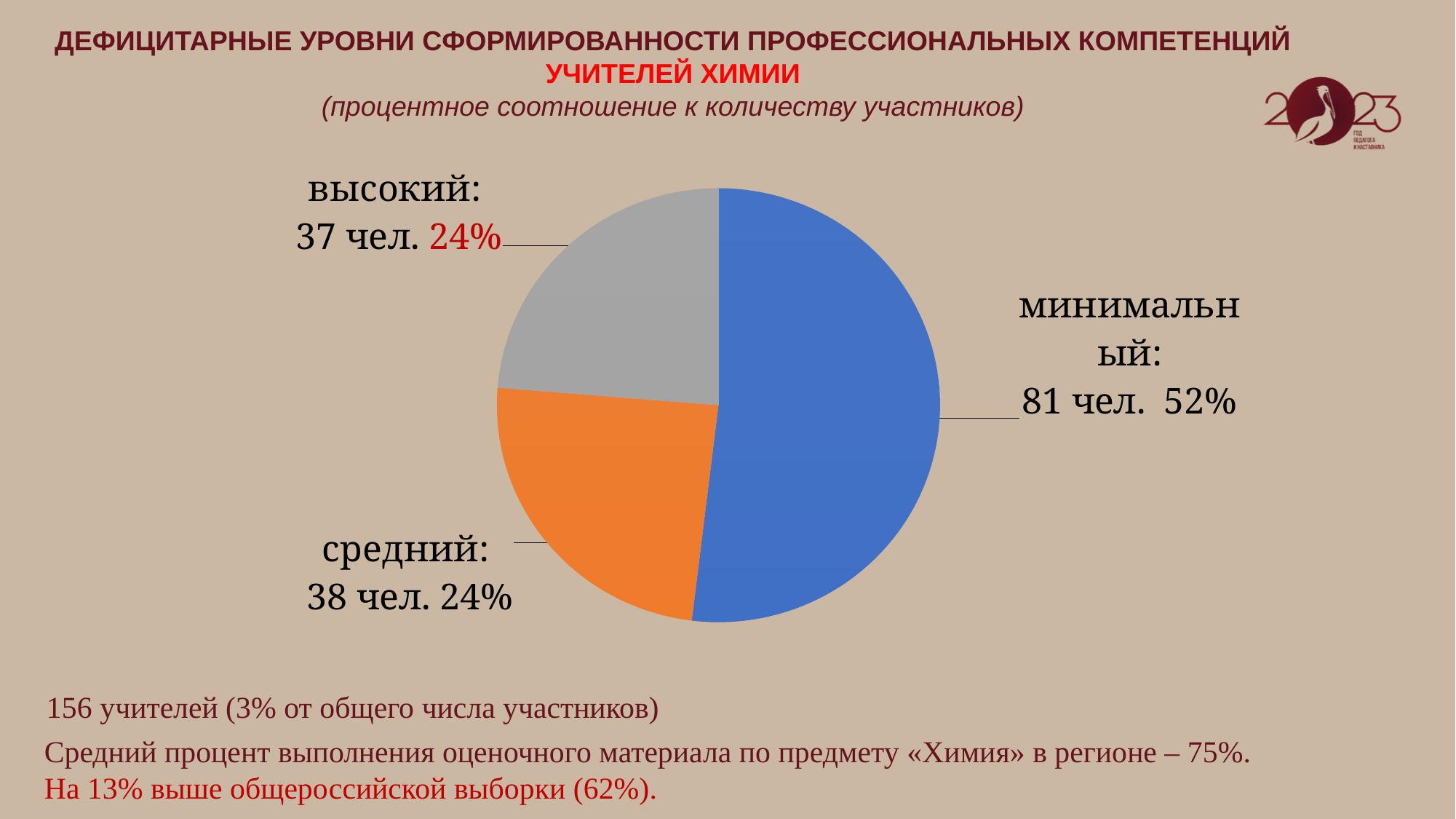
What is the total number of teachers across all three slices? 156 How many teachers (чел.) are in the 'средний' category? 38 чел. What colour is the 'минимальный' slice? blue What percentage share does the 'высокий' slice have? 24% How many teachers (чел.) are in the 'высокий' category? 37 чел. What is the difference in number of teachers between the 'минимальный' and 'высокий' categories? 44 чел. Which category has the largest slice of the pie? минимальный Which is larger, the 'минимальный' slice or the 'средний' slice? минимальный How many slices does the pie chart have? 3 What kind of chart is shown on the slide? pie chart What percentage share does the 'минимальный' slice have? 52% What is the difference in number of teachers between the 'средний' and 'высокий' categories? 1 чел.